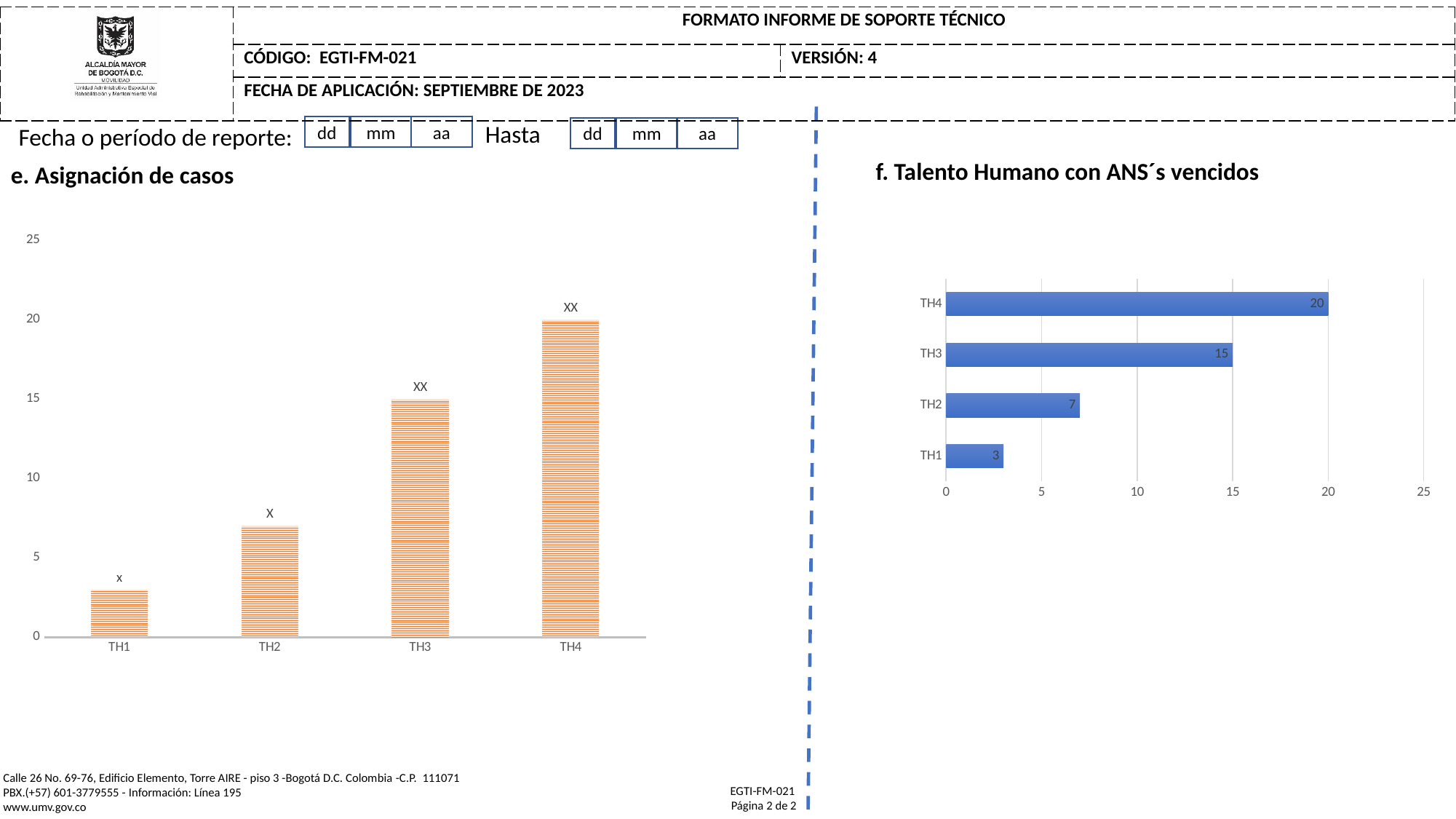
In the chart titled 'f. Talento Humano con ANS´s vencidos', what is the value for TH2? 7 What kind of chart is the chart titled 'f. Talento Humano con ANS´s vencidos'? Bar chart In the chart titled 'f. Talento Humano con ANS´s vencidos', which category has the highest value? TH4 In the chart titled 'f. Talento Humano con ANS´s vencidos', which category has the lowest value? TH1 In the chart titled 'e. Asignación de casos', which category has the tallest bar? TH4 In the chart titled 'f. Talento Humano con ANS´s vencidos', which is larger, the value for TH2 or the value for TH3? TH3 In the chart titled 'f. Talento Humano con ANS´s vencidos', what is the value for TH4? 20 In the chart titled 'e. Asignación de casos', is the value for TH1 greater or less than 5? less In the chart titled 'e. Asignación de casos', is the value for TH3 greater or less than 10? greater In the chart titled 'e. Asignación de casos', do the values rise or fall from TH1 to TH4? Rise In the chart titled 'f. Talento Humano con ANS´s vencidos', what is the difference between the values for TH3 and TH1? 12 In the chart titled 'f. Talento Humano con ANS´s vencidos', how many categories are shown? 4